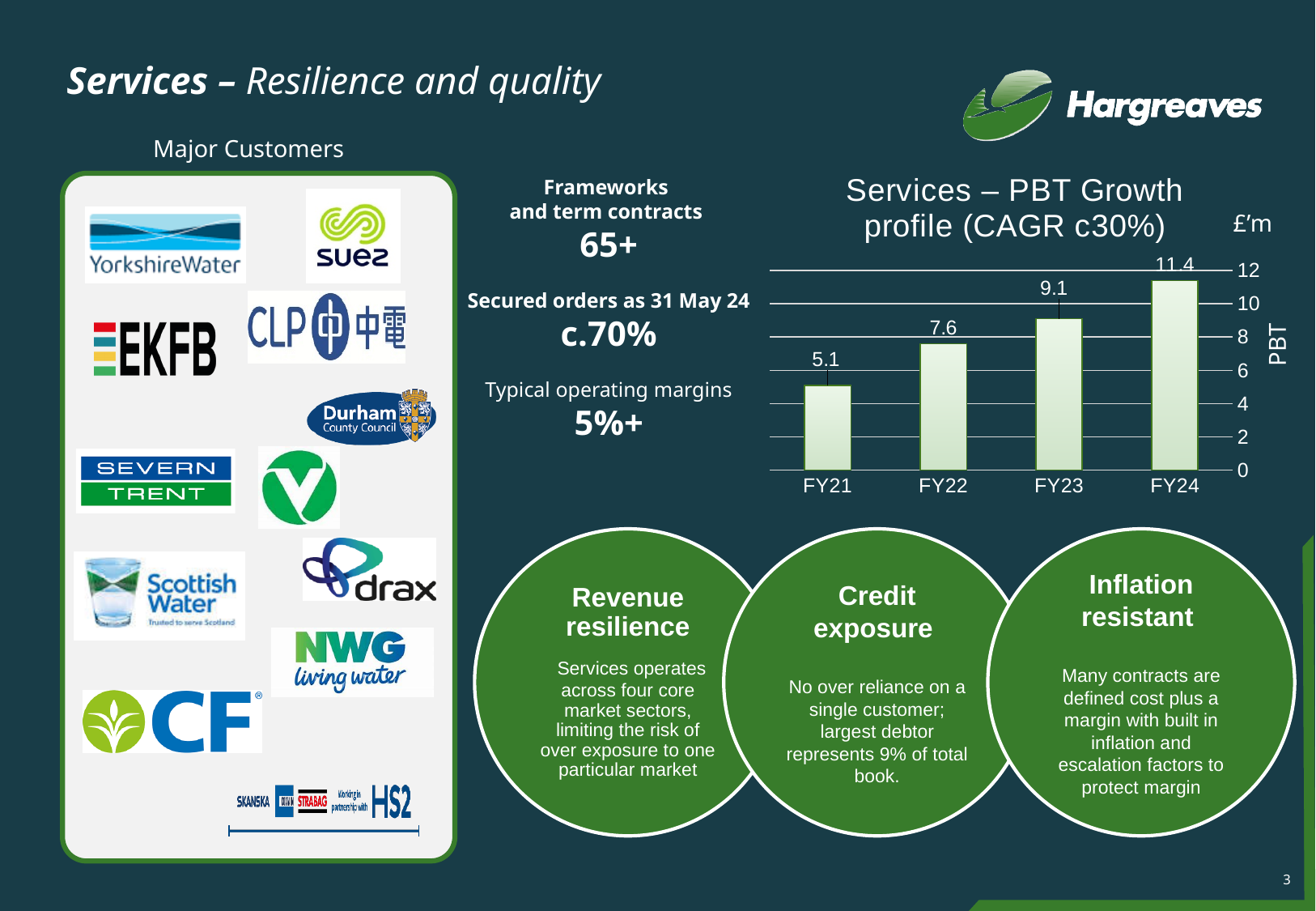
What is the PBT value for FY21? 5.1 Which year has the highest PBT? FY24 Which year has the lowest PBT? FY21 What is the difference in PBT between FY24 and FY21? 6.3 Do PBT values rise or fall from FY21 to FY24? Rise What kind of chart is used to show the PBT growth profile? Bar chart What is the PBT value for FY22? 7.6 How many years are shown on the chart? 4 What is the PBT value for FY24? 11.4 Which is larger, the PBT for FY22 or FY23? FY23 What is the title of the chart? Services – PBT Growth profile (CAGR c30%) What is the PBT value for FY23? 9.1